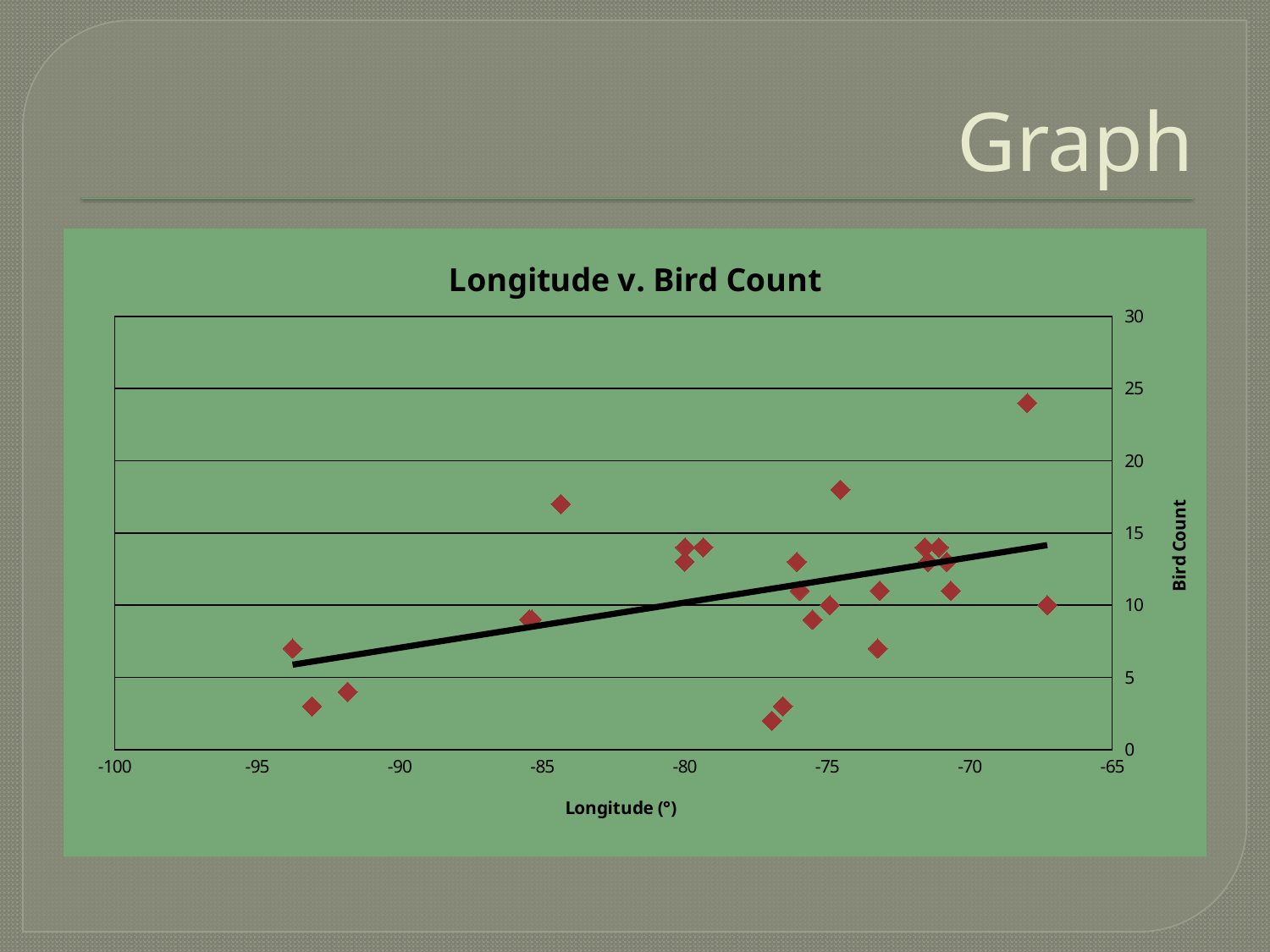
Is the lowest bird count plotted greater or less than 5? less What is the label of the x axis? Longitude (°) What type of chart is shown on the slide? Scatter chart Does the trendline rise or fall as longitude increases from -100 to -65? Rises What is the title of the chart? Longitude v. Bird Count Is the highest point plotted between longitude -75 and -70 greater or less than 15? greater Is the highest bird count plotted greater or less than 20? greater Which has the higher bird count: the point near longitude -68 or the point near longitude -67? The point near -68 Which has the higher bird count: the point near longitude -94 or the point near longitude -93? The point near -94